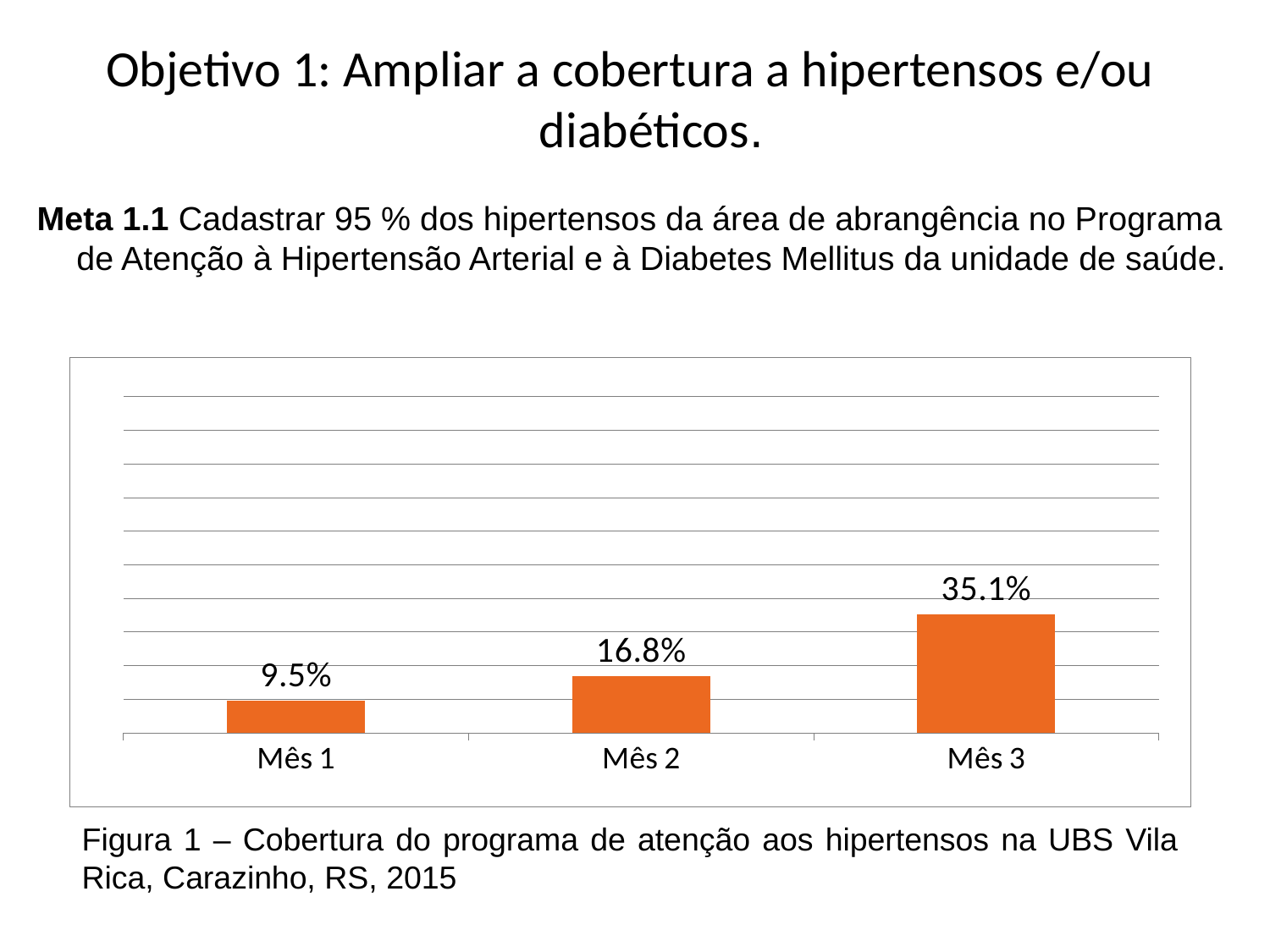
Which month has the highest value? Mês 3 What is the difference between the values for Mês 3 and Mês 2? 18.3% What is the value for Mês 2? 16.8% What is the difference between the values for Mês 2 and Mês 1? 7.3% How many months are shown on the x axis? 3 What is the value for Mês 1? 9.5% Do the values rise or fall from Mês 1 to Mês 3? Rise What is the value for Mês 3? 35.1% Which is larger, the value for Mês 1 or the value for Mês 2? Mês 2 Which month has the lowest value? Mês 1 What kind of chart is shown on the slide? Bar chart What colour are the bars in the chart? Orange